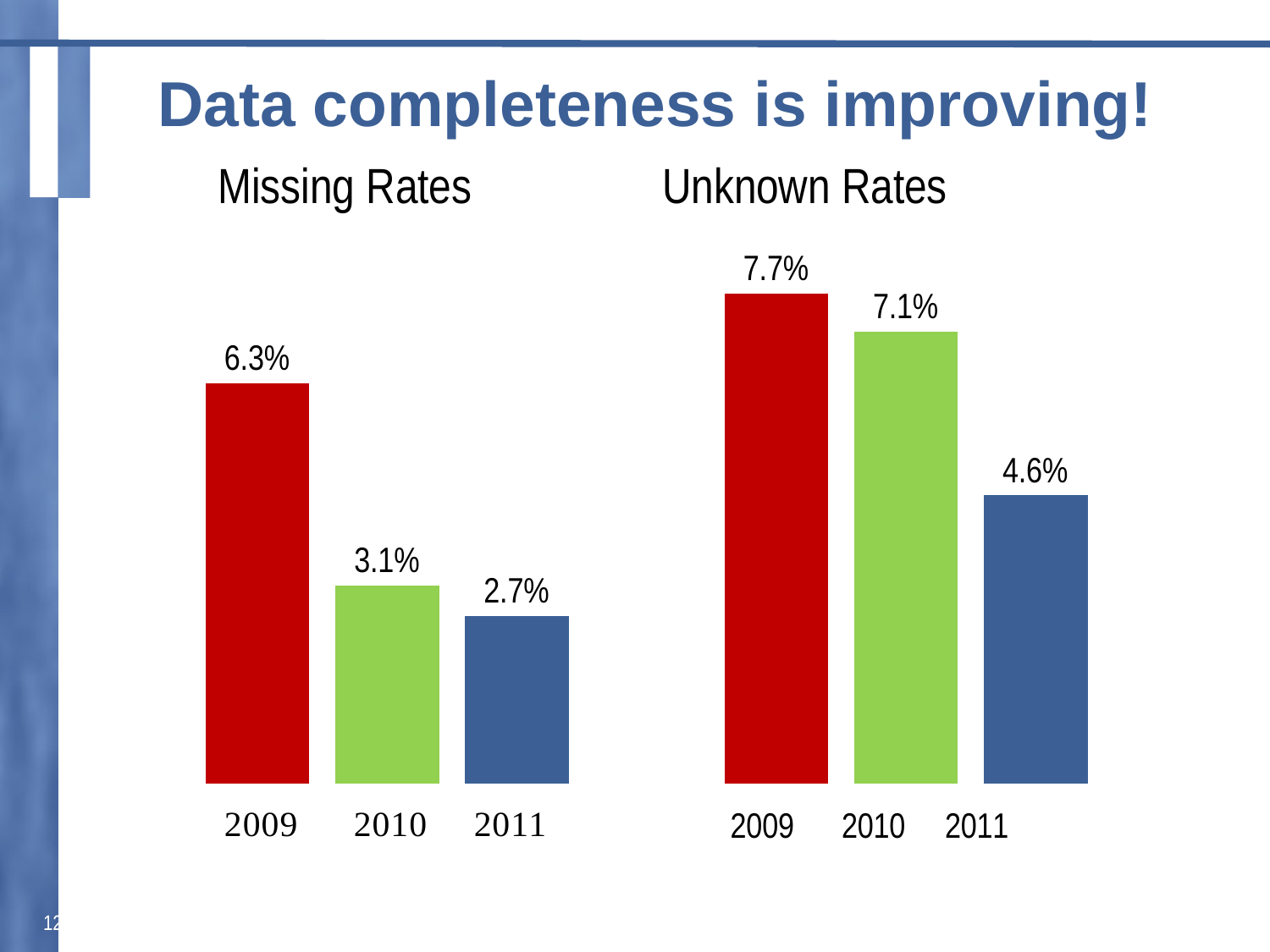
In the Missing Rates chart, what is the value for 2009? 6.3% In the Unknown Rates chart, which year has the highest value? 2009 In the Missing Rates chart, what is the value for 2010? 3.1% How many bars are in the Missing Rates chart? 3 What is the title of the chart on the right side of the slide? Unknown Rates In the Missing Rates chart, do the values rise or fall from 2009 to 2011? Fall In the Unknown Rates chart, what is the value for 2011? 4.6% What kind of chart is the Unknown Rates chart? Bar chart In the Unknown Rates chart, what is the difference between the 2010 and 2011 values? 2.5% In the Missing Rates chart, what is the difference between the 2009 and 2011 values? 3.6% In the Missing Rates chart, which year has the lowest value? 2011 In the Unknown Rates chart, which is larger, the value for 2009 or the value for 2010? 2009